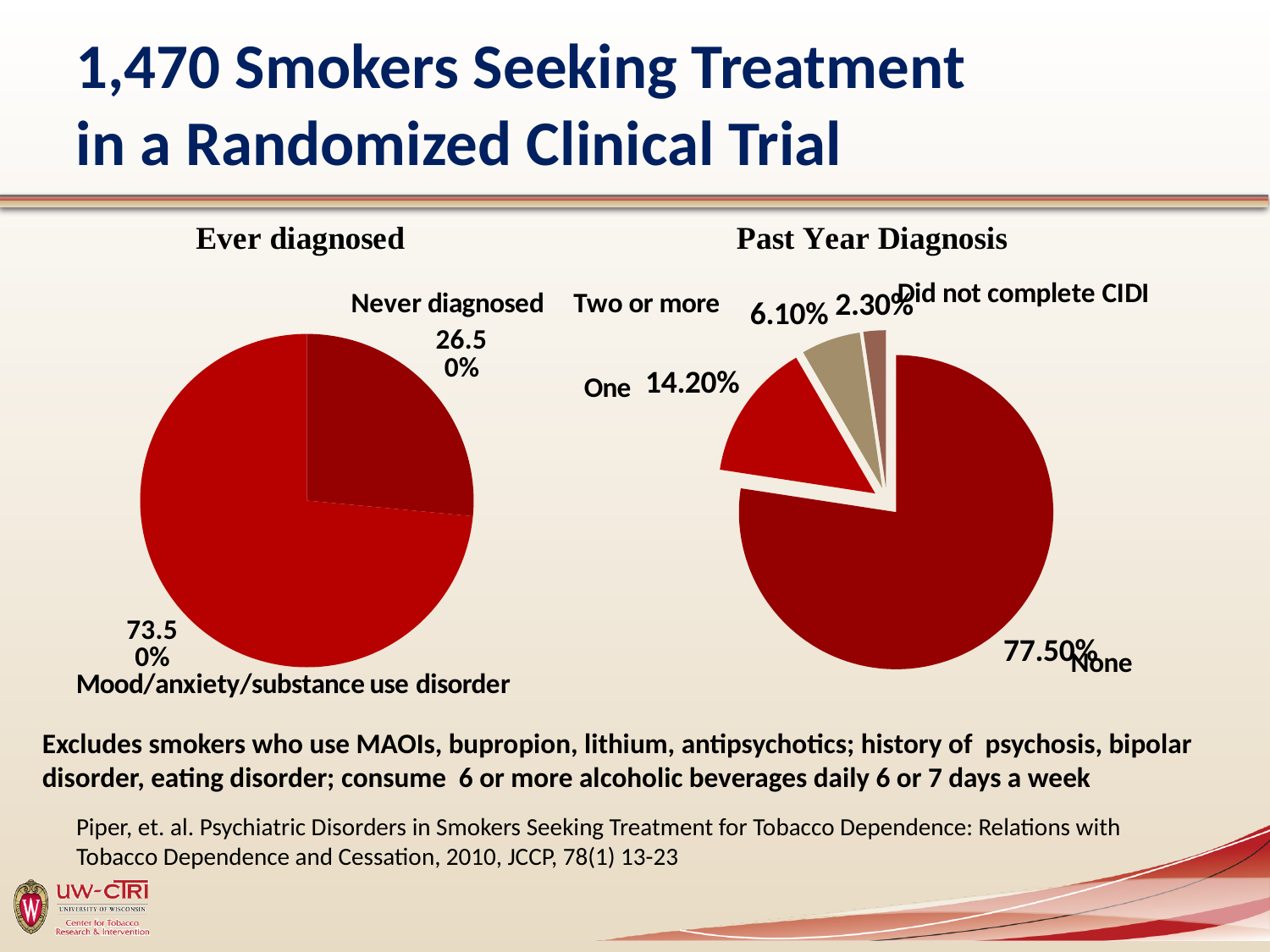
In the "Ever diagnosed" chart, which slice is larger: "Never diagnosed" or "Mood/anxiety/substance use disorder"? Mood/anxiety/substance use disorder In the "Ever diagnosed" chart, how many slices does the pie have? 2 In the "Past Year Diagnosis" chart, what share is labelled for "None"? 77.50% In the "Past Year Diagnosis" chart, what share is labelled for "One"? 14.20% In the "Past Year Diagnosis" chart, which category has the smallest slice? Did not complete CIDI In the "Past Year Diagnosis" chart, which category has the largest slice? None In the "Past Year Diagnosis" chart, what share is labelled for "Two or more"? 6.10% What kind of chart is the "Ever diagnosed" chart on the left? pie chart In the "Past Year Diagnosis" chart, what is the difference between the "One" and "Two or more" shares? 8.10% What is the title of the pie chart on the right? Past Year Diagnosis In the "Past Year Diagnosis" chart, how many slices does the pie have? 4 In the "Past Year Diagnosis" chart, what share is labelled for "Did not complete CIDI"? 2.30%